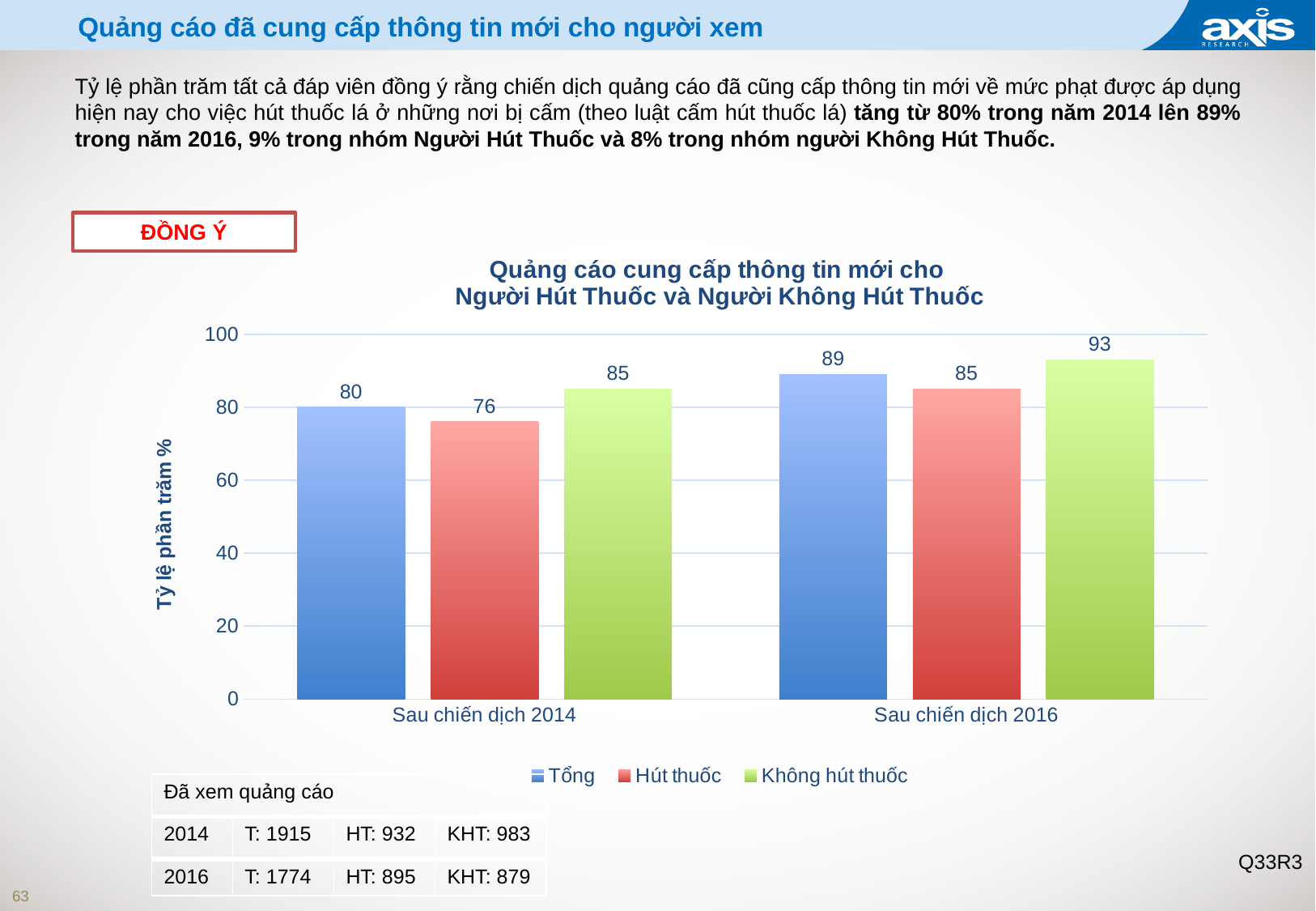
Which series has the lowest value in Sau chiến dịch 2014? Hút thuốc What kind of chart is shown? Bar chart What is the value for Tổng in Sau chiến dịch 2014? 80 What is the label of the y axis? Tỷ lệ phần trăm % Which is larger: Không hút thuốc in Sau chiến dịch 2014 or Không hút thuốc in Sau chiến dịch 2016? Sau chiến dịch 2016 What is the difference between the Tổng values for Sau chiến dịch 2016 and Sau chiến dịch 2014? 9 Which series has the highest value in Sau chiến dịch 2016? Không hút thuốc What is the difference between the Hút thuốc values for Sau chiến dịch 2016 and Sau chiến dịch 2014? 9 How many series does the legend list? 3 How many categories are shown on the x axis? 2 What is the value for Không hút thuốc in Sau chiến dịch 2014? 85 What is the value for Hút thuốc in Sau chiến dịch 2016? 85